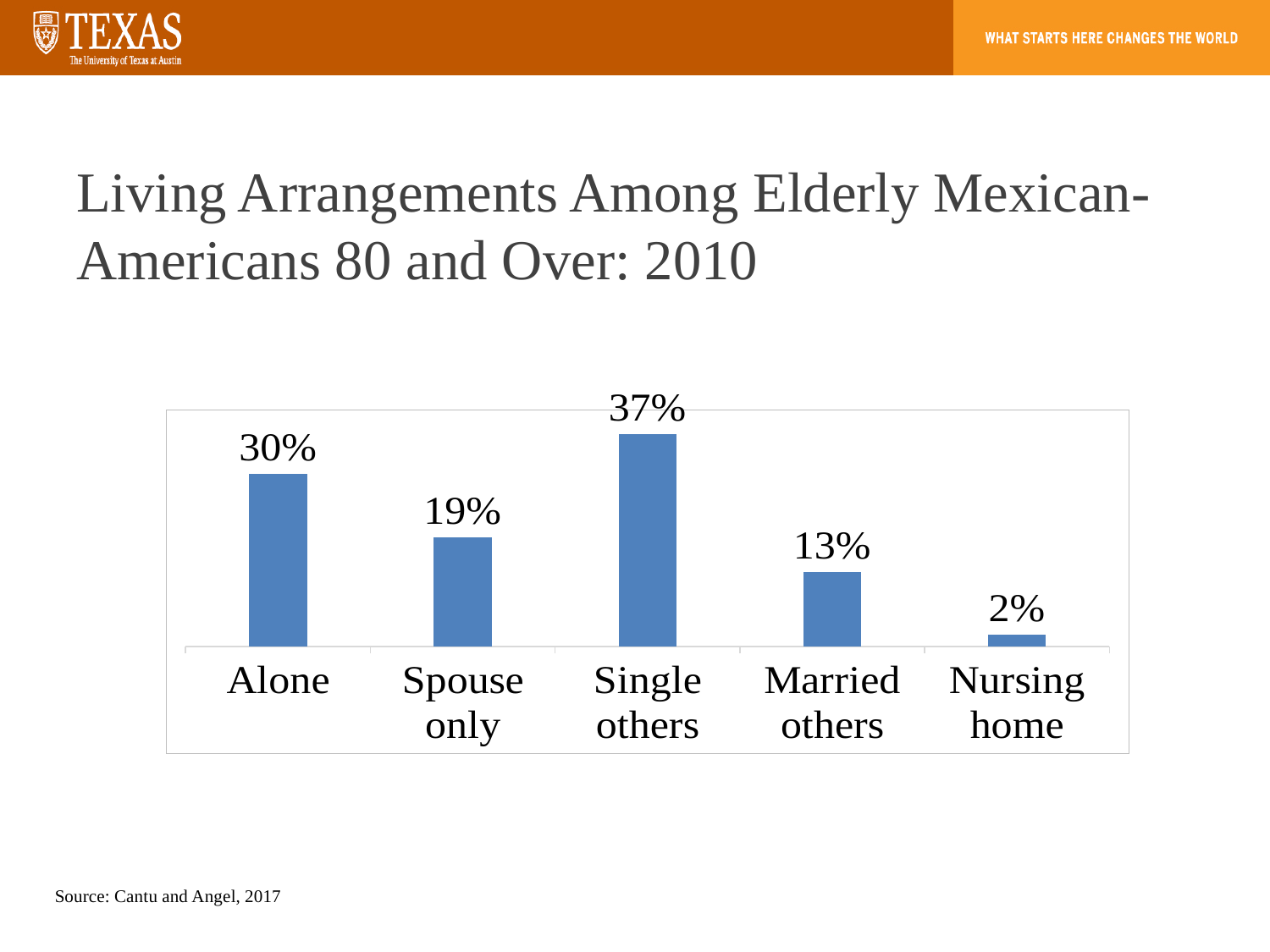
What is the difference between the 'Single others' and 'Alone' percentages? 7% What is the difference between the 'Spouse only' and 'Married others' percentages? 6% What is the title of the slide containing the chart? Living Arrangements Among Elderly Mexican-Americans 80 and Over: 2010 What kind of chart is shown on the slide? Bar chart What percentage of elderly Mexican-Americans 80 and over live alone? 30% Which living arrangement has the highest percentage? Single others What is the value shown for 'Married others'? 13% Which living arrangement has the lowest percentage? Nursing home What is the value shown for the 'Spouse only' category? 19% What percentage live in a nursing home? 2% Which is larger, the value for 'Alone' or the value for 'Spouse only'? Alone How many living arrangement categories are shown in the chart? 5